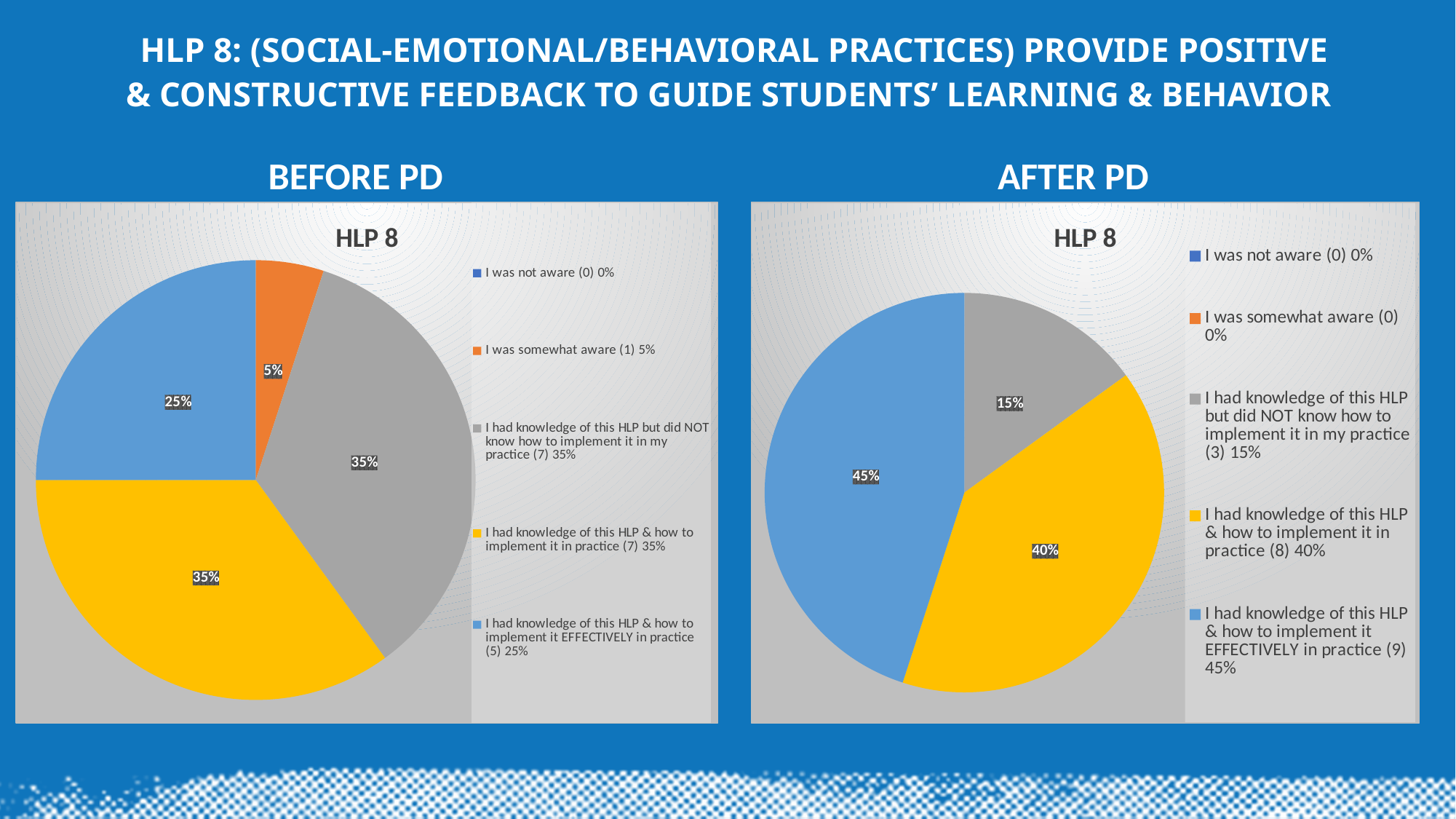
How many categories does the legend of the AFTER PD chart list? 5 In the AFTER PD chart, what is the difference between the share for 'I had knowledge of this HLP & how to implement it in practice' and the share for 'I had knowledge of this HLP but did NOT know how to implement it in my practice'? 25% Which is larger: the share for 'I had knowledge of this HLP & how to implement it EFFECTIVELY in practice' in the BEFORE PD chart or in the AFTER PD chart? AFTER PD What is the title shown inside the BEFORE PD chart? HLP 8 In the BEFORE PD chart, what share is shown for 'I was somewhat aware'? 5% In the AFTER PD chart, what share is shown for 'I had knowledge of this HLP but did NOT know how to implement it in my practice'? 15% In the AFTER PD chart, what share is shown for 'I had knowledge of this HLP & how to implement it EFFECTIVELY in practice'? 45% What kind of chart is the BEFORE PD chart? pie chart In the BEFORE PD chart, which category with a non-zero share has the smallest share? I was somewhat aware In the BEFORE PD chart, how many respondents chose 'I had knowledge of this HLP but did NOT know how to implement it in my practice'? 7 In the BEFORE PD chart, what share is shown for 'I had knowledge of this HLP & how to implement it EFFECTIVELY in practice'? 25% In the AFTER PD chart, which category has the largest share? I had knowledge of this HLP & how to implement it EFFECTIVELY in practice